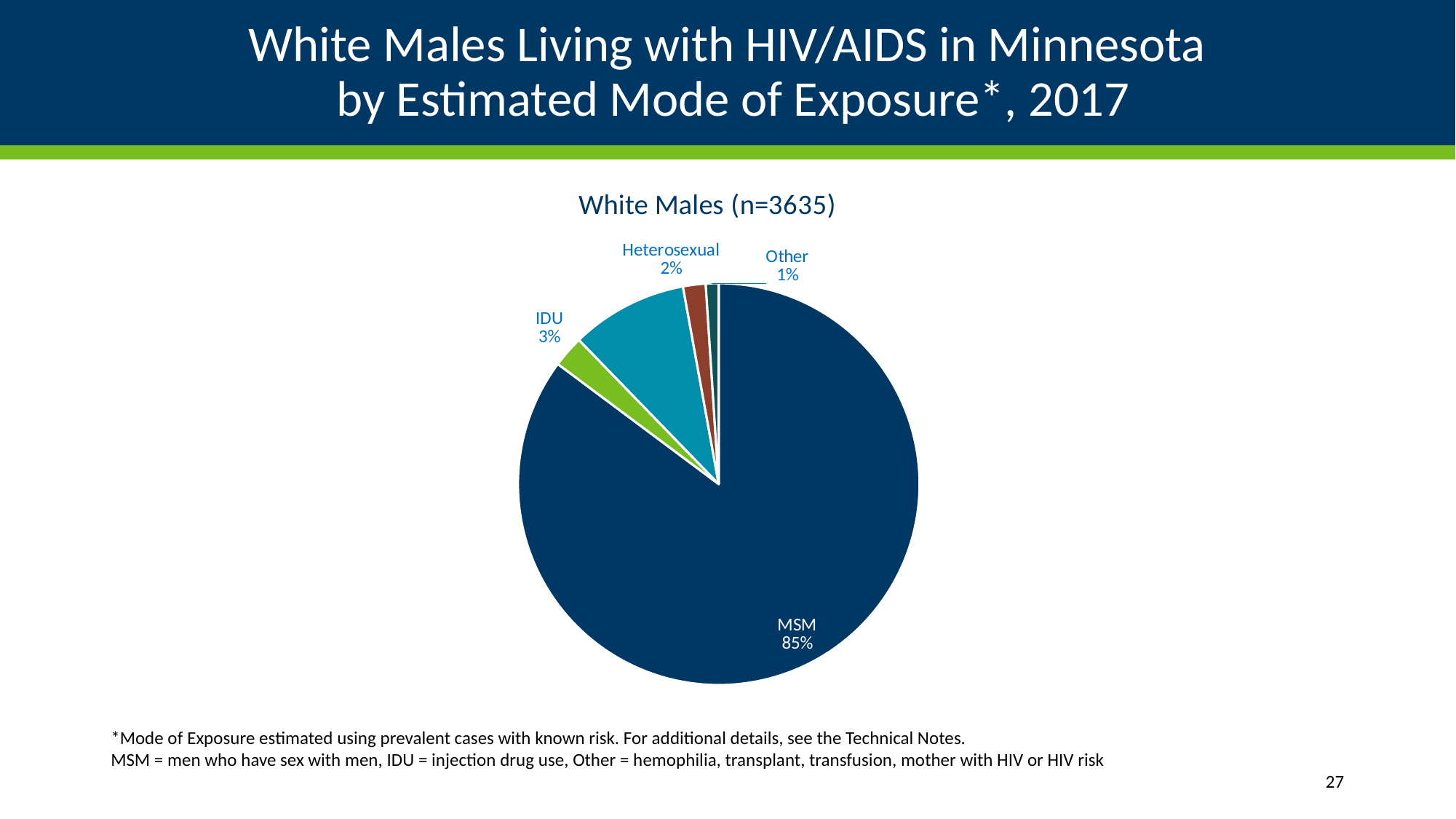
What percentage of the pie is labeled IDU? 3% Which labeled mode of exposure has the smallest share of the pie? Other What percentage of white males living with HIV/AIDS in Minnesota have MSM as their estimated mode of exposure? 85% Which mode of exposure has the largest share of the pie? MSM By how many percentage points does the MSM share exceed the IDU share? 82 percentage points What is the title of the chart on the slide? White Males (n=3635) Which has a larger share, IDU or Heterosexual? IDU What is the total number of white males (n) shown in the chart title? 3635 What is the combined share of the IDU and Heterosexual slices? 5% What type of chart is shown on the slide? Pie chart What percentage is shown for the Other category? 1% What share of the pie is attributed to Heterosexual exposure? 2%